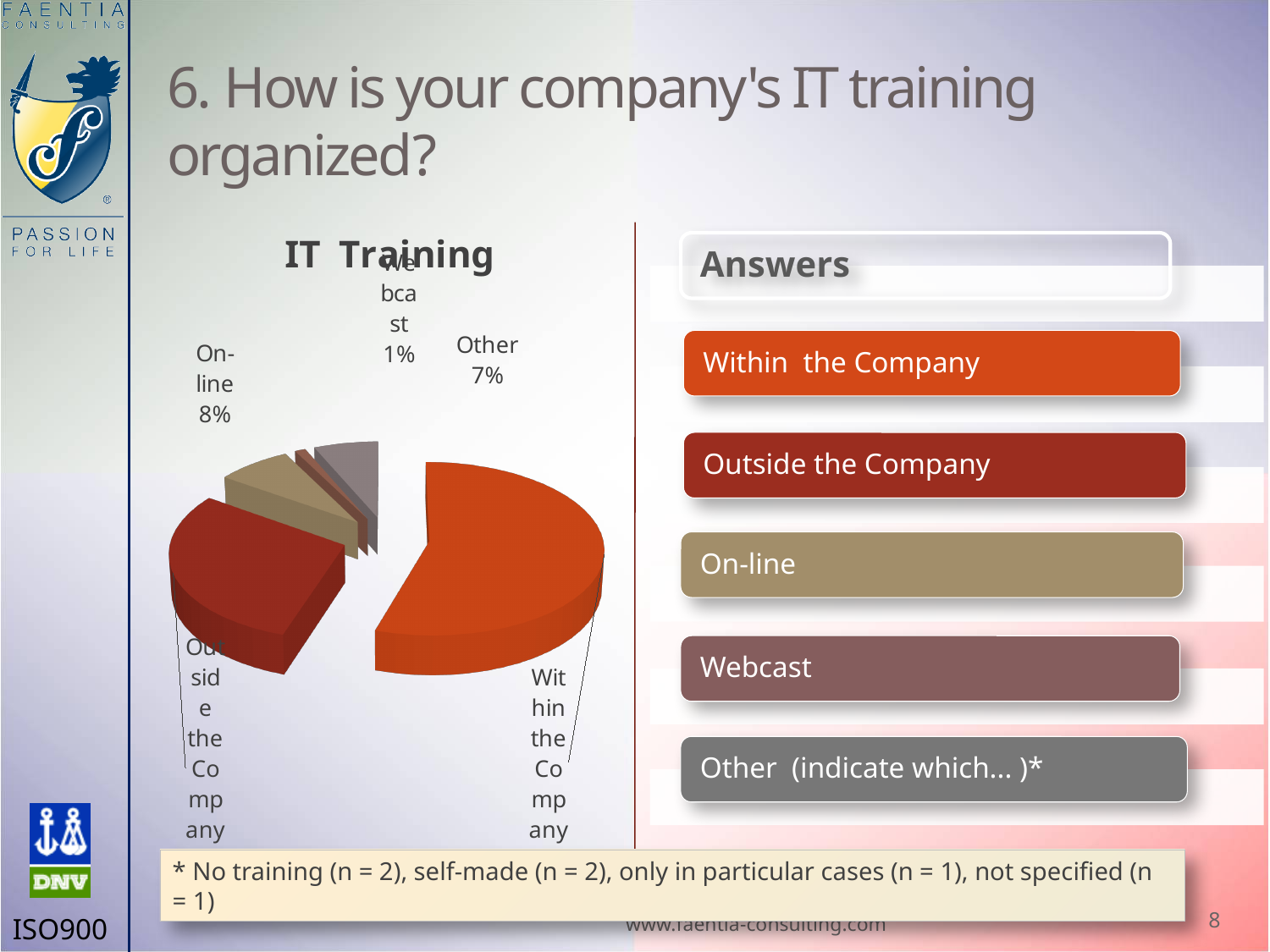
What is the title of the chart? IT Training What is the difference in percentage points between the On-line slice and the Webcast slice? 7% Which slice is larger, On-line or Other? On-line What percentage of the pie does Other represent? 7% What percentage of the pie does On-line represent? 8% How many slices does the pie chart have? 5 What percentage of the pie does Webcast represent? 1% Which category has the largest slice of the pie? Within the Company What kind of chart is shown on the slide? pie chart Which slice is larger, Within the Company or Outside the Company? Within the Company Which category has the smallest slice of the pie? Webcast What is the difference in percentage points between the Other slice and the Webcast slice? 6%